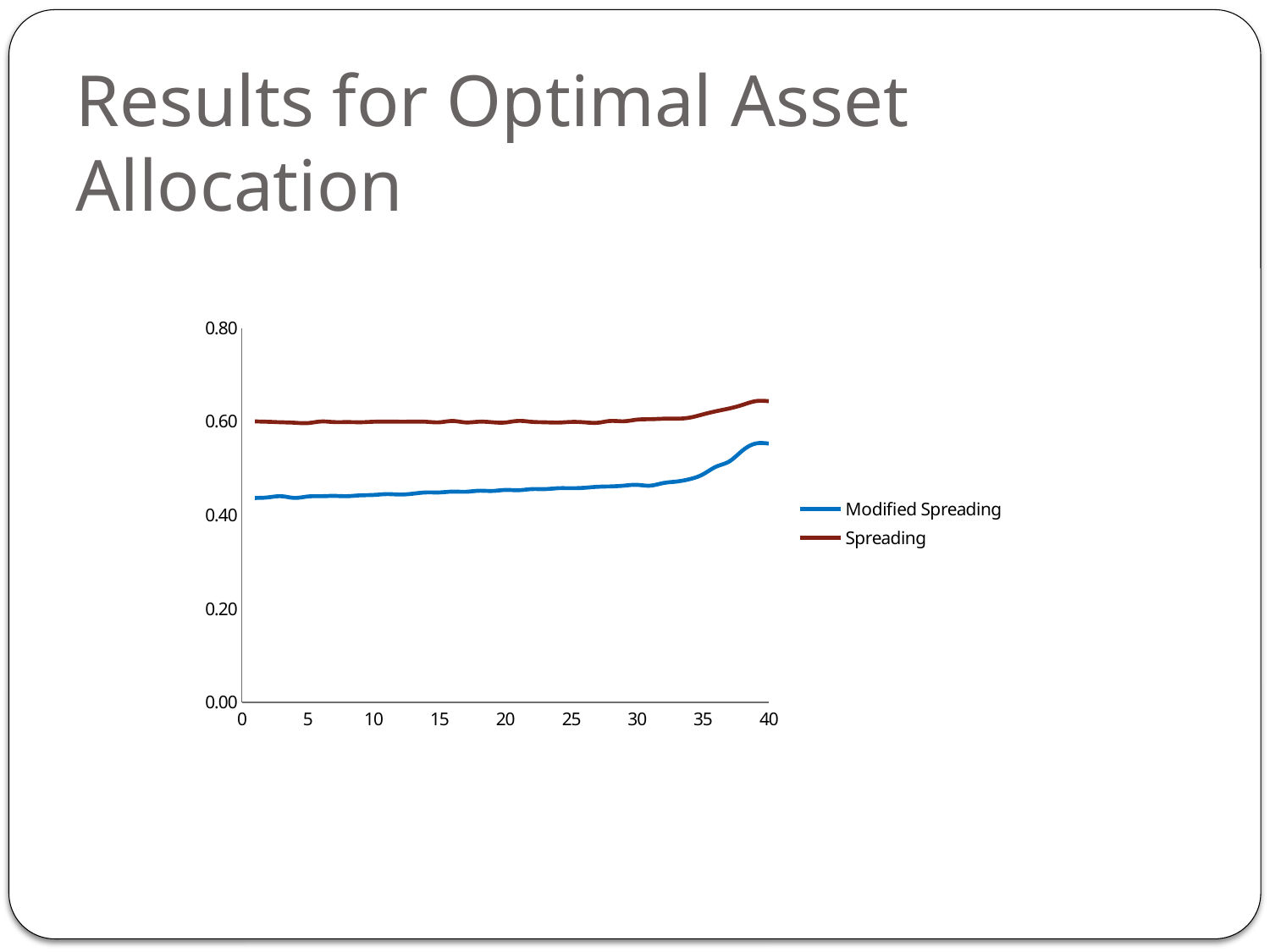
Does the Spreading line rise or fall between x = 35 and x = 40? rise Is the value for Modified Spreading at x = 10 greater or less than 0.40? greater What are the two series named in the legend? Modified Spreading and Spreading Is the value for Modified Spreading at x = 40 greater or less than 0.60? less How many series does the legend list? 2 Is the value for Modified Spreading at x = 10 greater or less than 0.60? less At x = 20, which series is larger, Modified Spreading or Spreading? Spreading Which series has the higher values across the x axis, Spreading or Modified Spreading? Spreading Does the Modified Spreading line rise or fall between x = 30 and x = 40? rise Which series is drawn in blue? Modified Spreading What kind of chart is shown on the slide? line chart